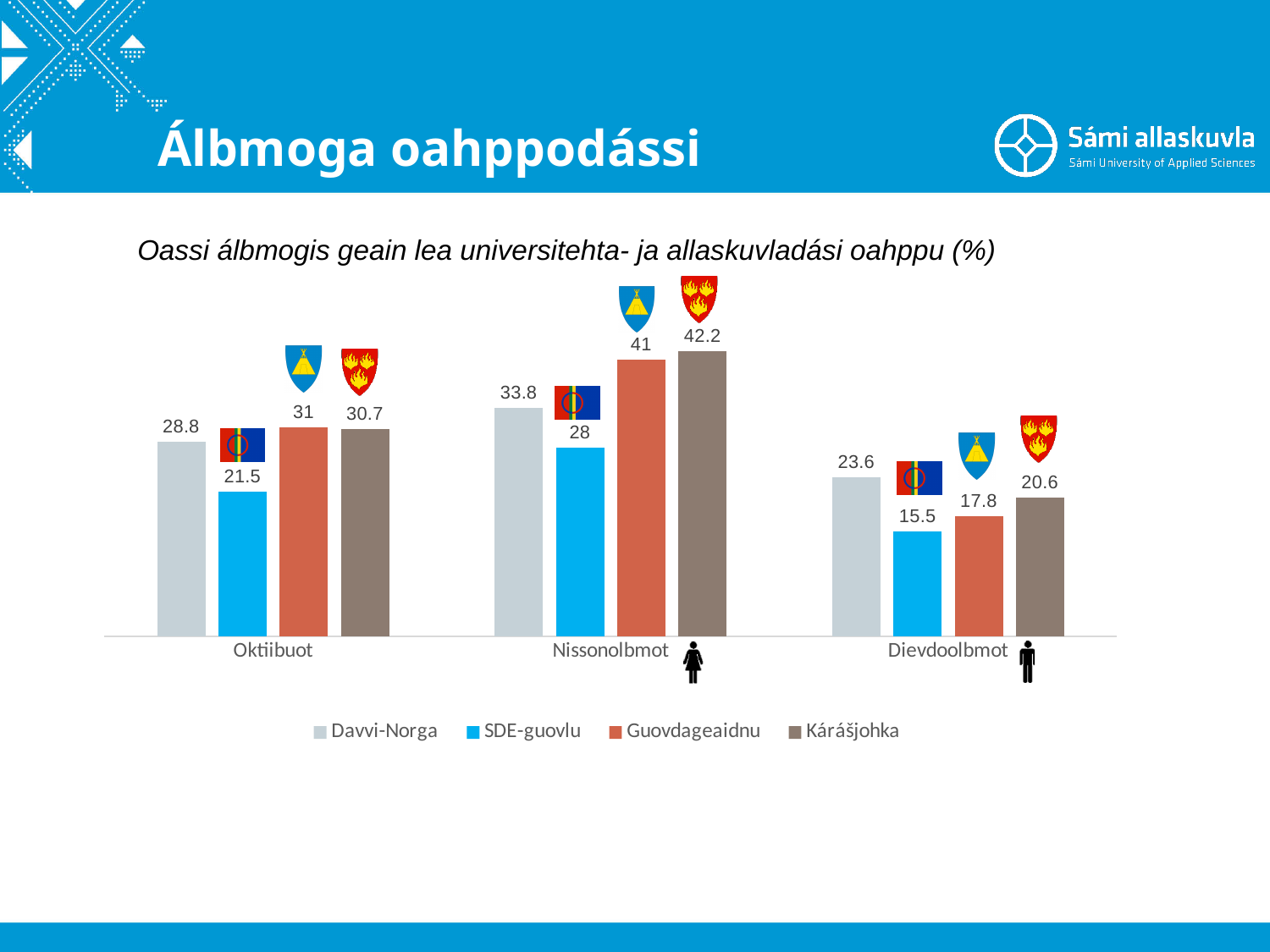
How many categories are shown on the x axis? 3 What is the value for SDE-guovlu in the Dievdoolbmot group? 15.5 How many series does the legend list? 4 What kind of chart is shown on the slide? Bar chart Which series has the lowest value in the Dievdoolbmot group? SDE-guovlu What is the value for Kárášjohka in the Nissonolbmot group? 42.2 What is the value for Guovdageaidnu in the Nissonolbmot group? 41 What is the difference between the Davvi-Norga and SDE-guovlu values in the Oktiibuot group? 7.3 Which is larger in the Dievdoolbmot group: Guovdageaidnu or Kárášjohka? Kárášjohka What is the title of the chart? Oassi álbmogis geain lea universitehta- ja allaskuvladási oahppu (%) Which series has the highest value in the Nissonolbmot group? Kárášjohka What is the value for Davvi-Norga in the Oktiibuot group? 28.8